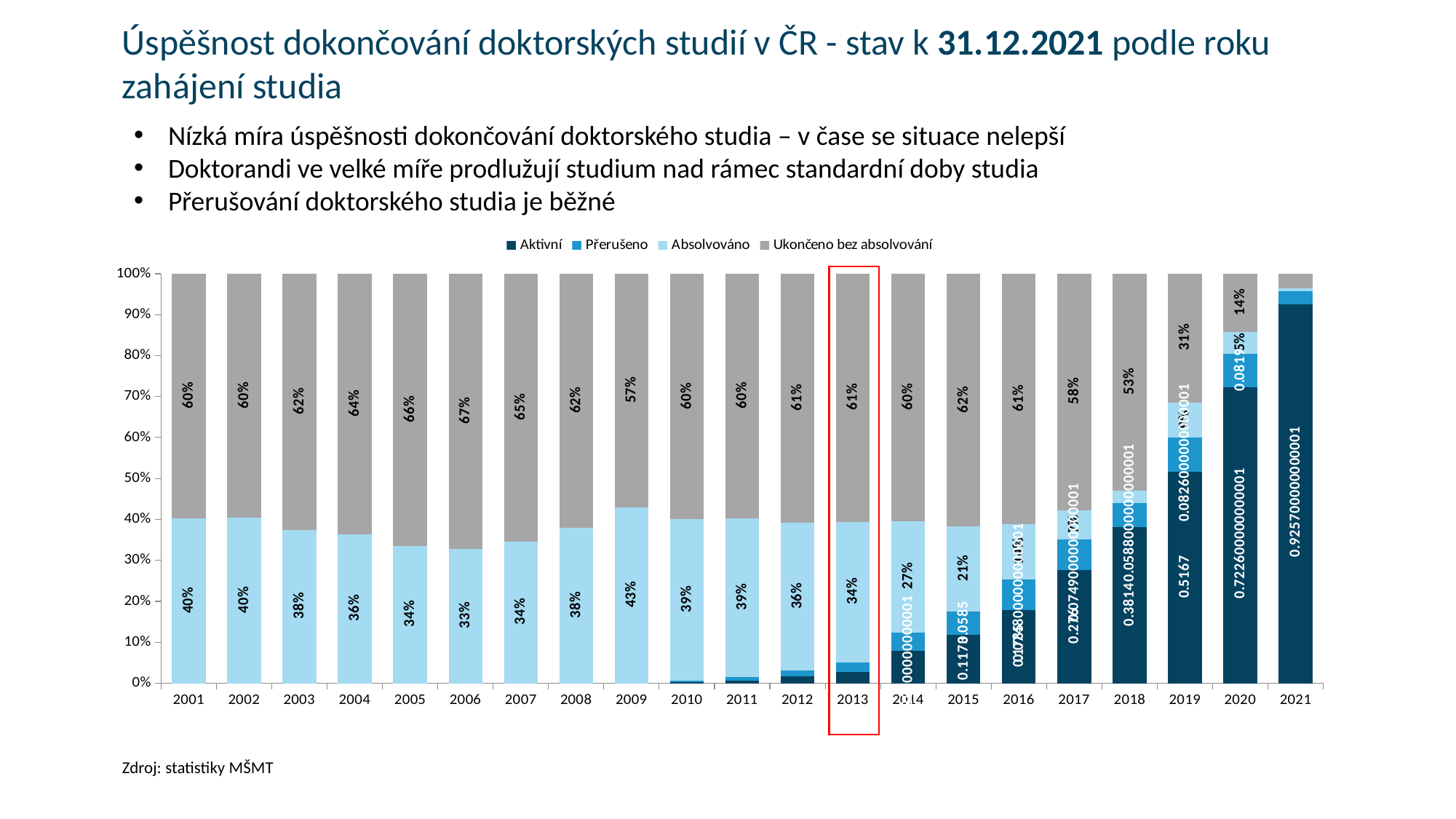
What is the difference between the Ukončeno bez absolvování values for 2006 and 2018? 14% What is the value of Ukončeno bez absolvování for 2020? 14% How many series does the legend list? 4 What kind of chart is shown on the slide? stacked bar chart Is the Aktivní value for 2021 greater or less than 90%? greater What is the value of Ukončeno bez absolvování for 2006? 67% Is the Absolvováno value for 2013 larger or smaller than for 2008? smaller Which year has the highest labelled Absolvováno share? 2009 What is the value of Absolvováno for 2015? 21% What is the value of Aktivní for 2019? 0.5167 What is the value of Absolvováno for 2009? 43% How many years (categories) are shown on the x axis? 21